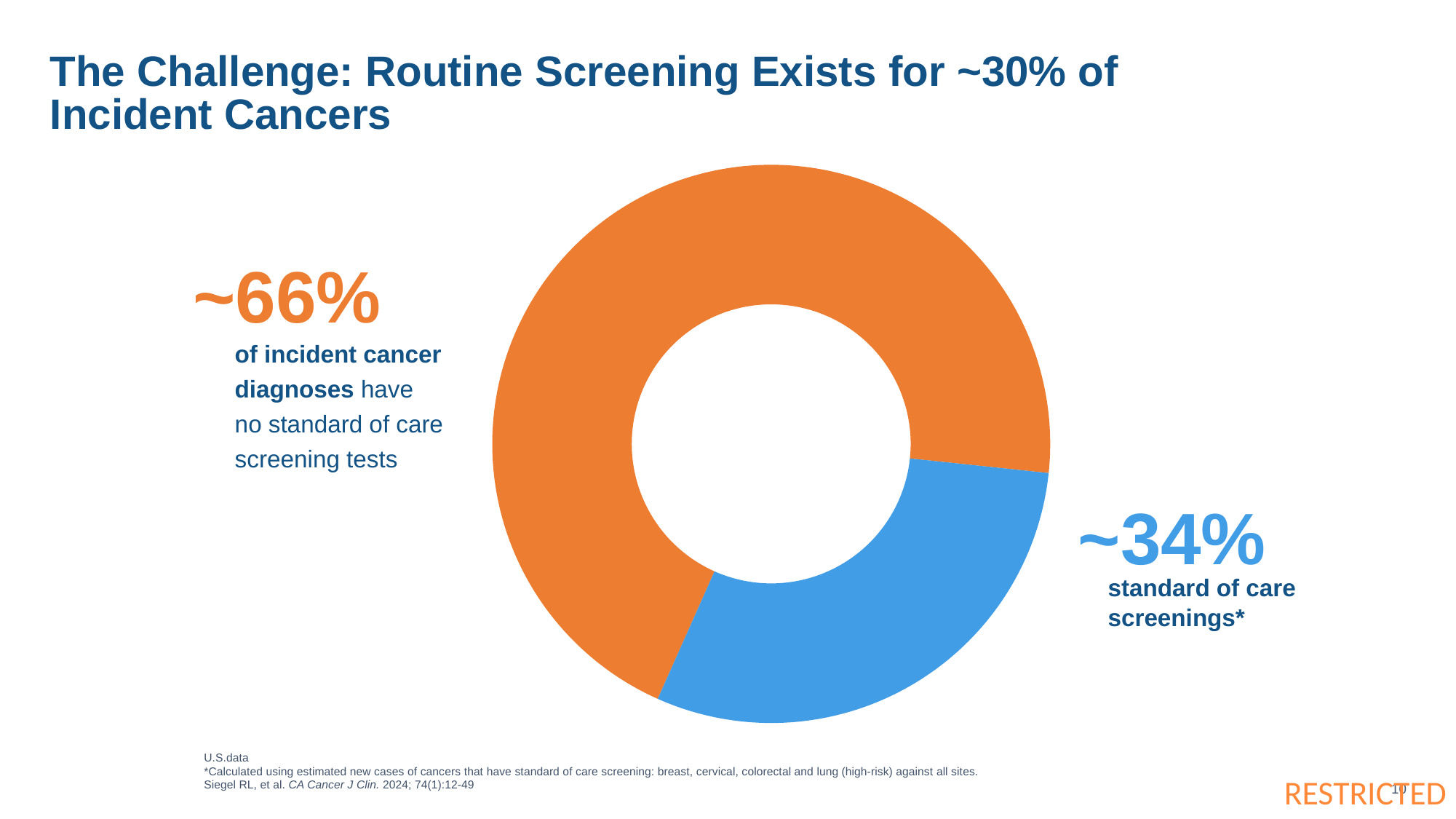
Which category has the largest slice in the chart? No standard of care screening tests (~66%) Which category has the smallest slice in the chart? Standard of care screenings (~34%) What kind of chart is shown on the slide? Pie chart (donut) What colour is the slice representing incident cancer diagnoses with no standard of care screening tests? Orange What colour is the slice representing standard of care screenings? Blue What share of incident cancer diagnoses have no standard of care screening tests, according to the chart? ~66% How many slices does the chart have? 2 Which slice of the chart is larger: no standard of care screening tests or standard of care screenings? No standard of care screening tests Is the share of diagnoses with no standard of care screening tests greater or less than 50%? greater Is the share of standard of care screenings greater or less than 50%? less What share of incident cancer diagnoses have standard of care screenings, according to the chart? ~34%